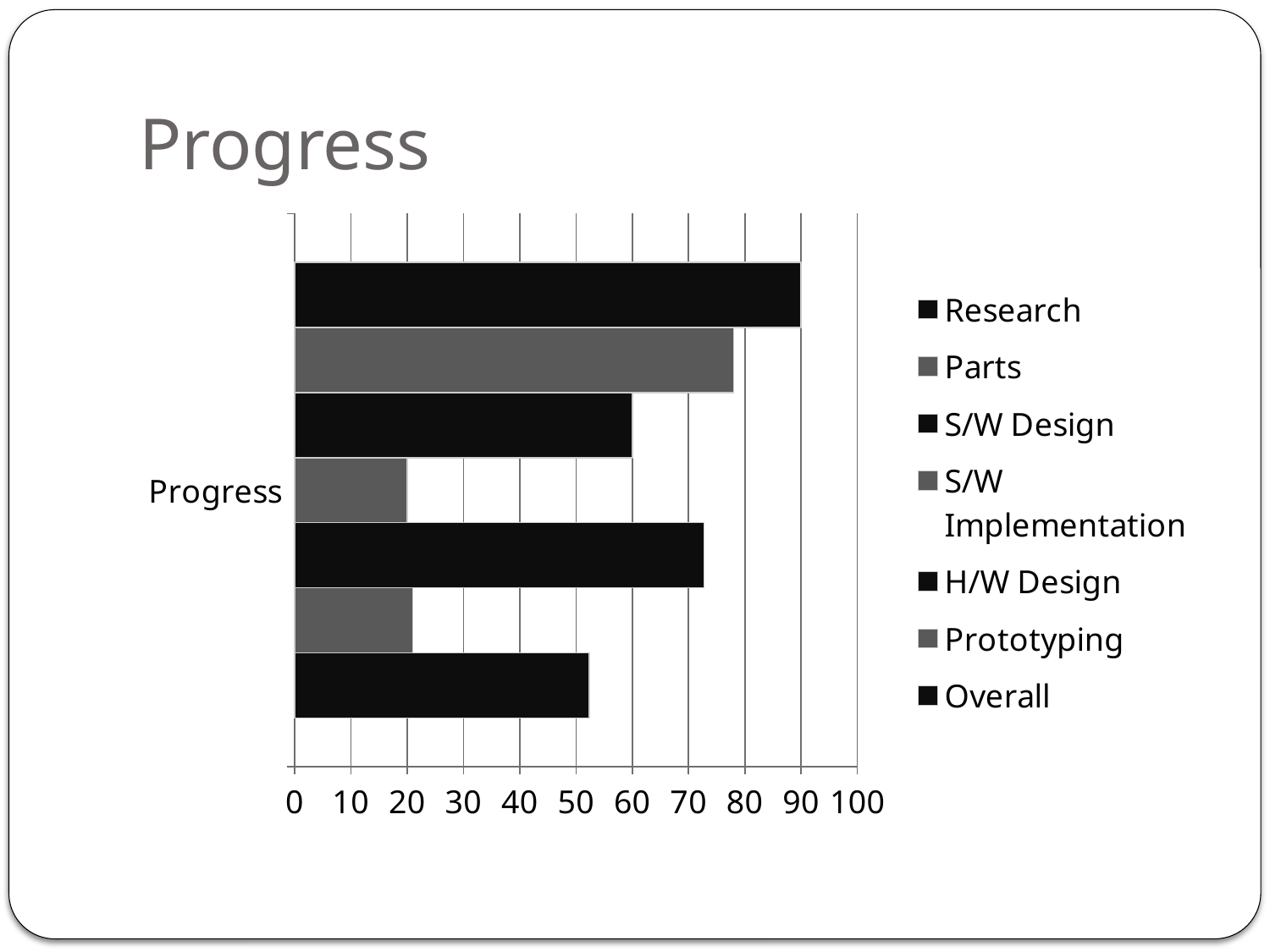
Which is larger, the value for Overall or the value for Research? Research What kind of chart is shown on the slide? bar chart Is the value for Overall greater or less than 60? less Is the value for H/W Design greater or less than 70? greater Which is larger, the value for S/W Design or the value for H/W Design? H/W Design Is the value for Parts greater or less than 70? greater Which series has the highest value? Research What is the value for Research? 90 What is the title of the slide? Progress How many series does the legend list? 7